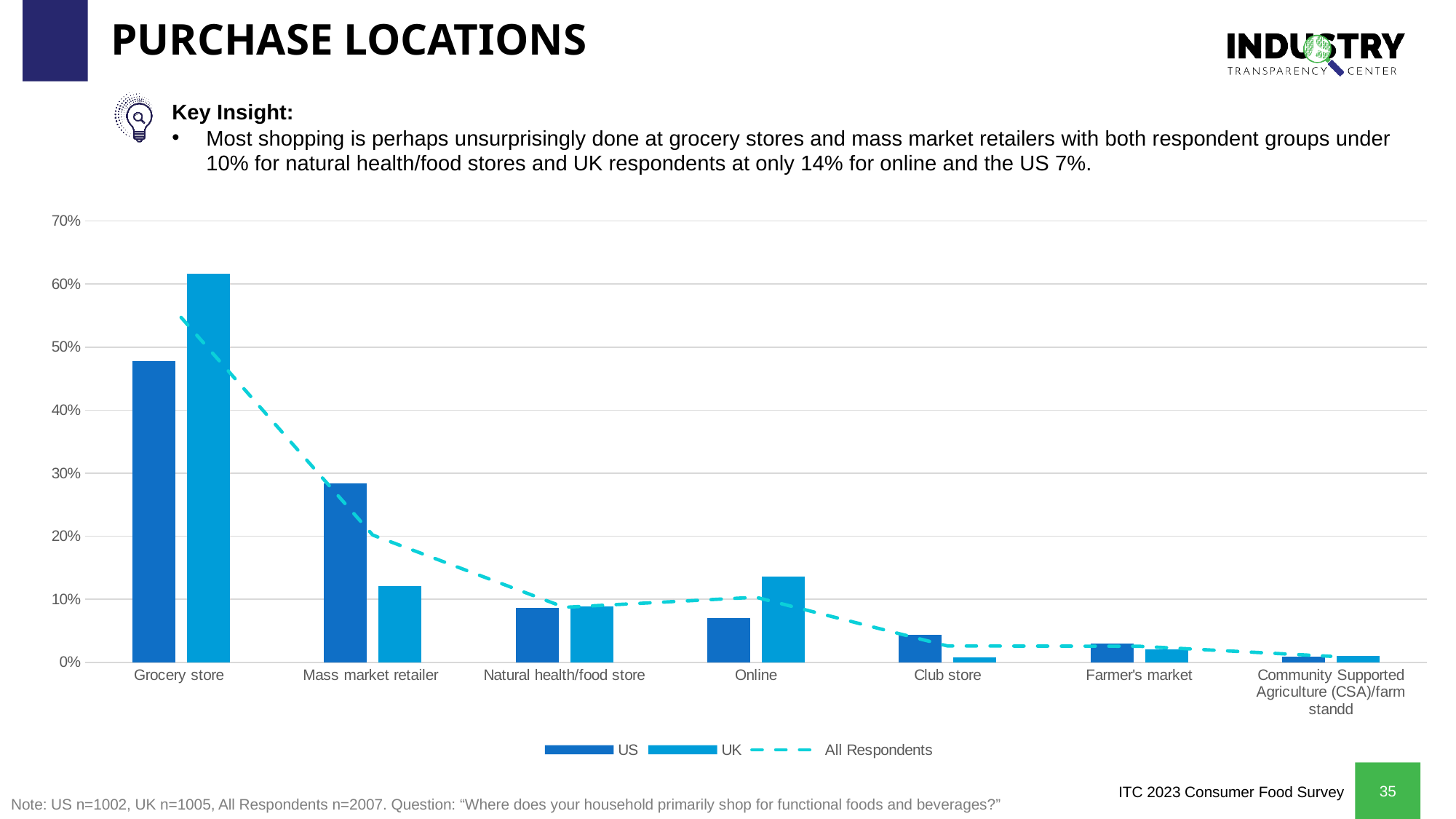
How many purchase location categories are shown on the x axis? 7 Is the US value for Grocery store greater or less than 50%? less What kind of chart is shown on the slide? Bar chart with a dashed line For Mass market retailer, which is larger, the US bar or the UK bar? US For Online, which is larger, the US bar or the UK bar? UK How many series does the legend list? 3 Is the US value for Mass market retailer greater or less than 30%? less Does the All Respondents dashed line generally rise or fall from Grocery store to Community Supported Agriculture (CSA)/farm standd? fall Which purchase location has the highest US bar? Grocery store Which purchase location has the lowest US bar? Community Supported Agriculture (CSA)/farm standd Which purchase location has the highest UK bar? Grocery store Is the UK value for Grocery store greater or less than 50%? greater